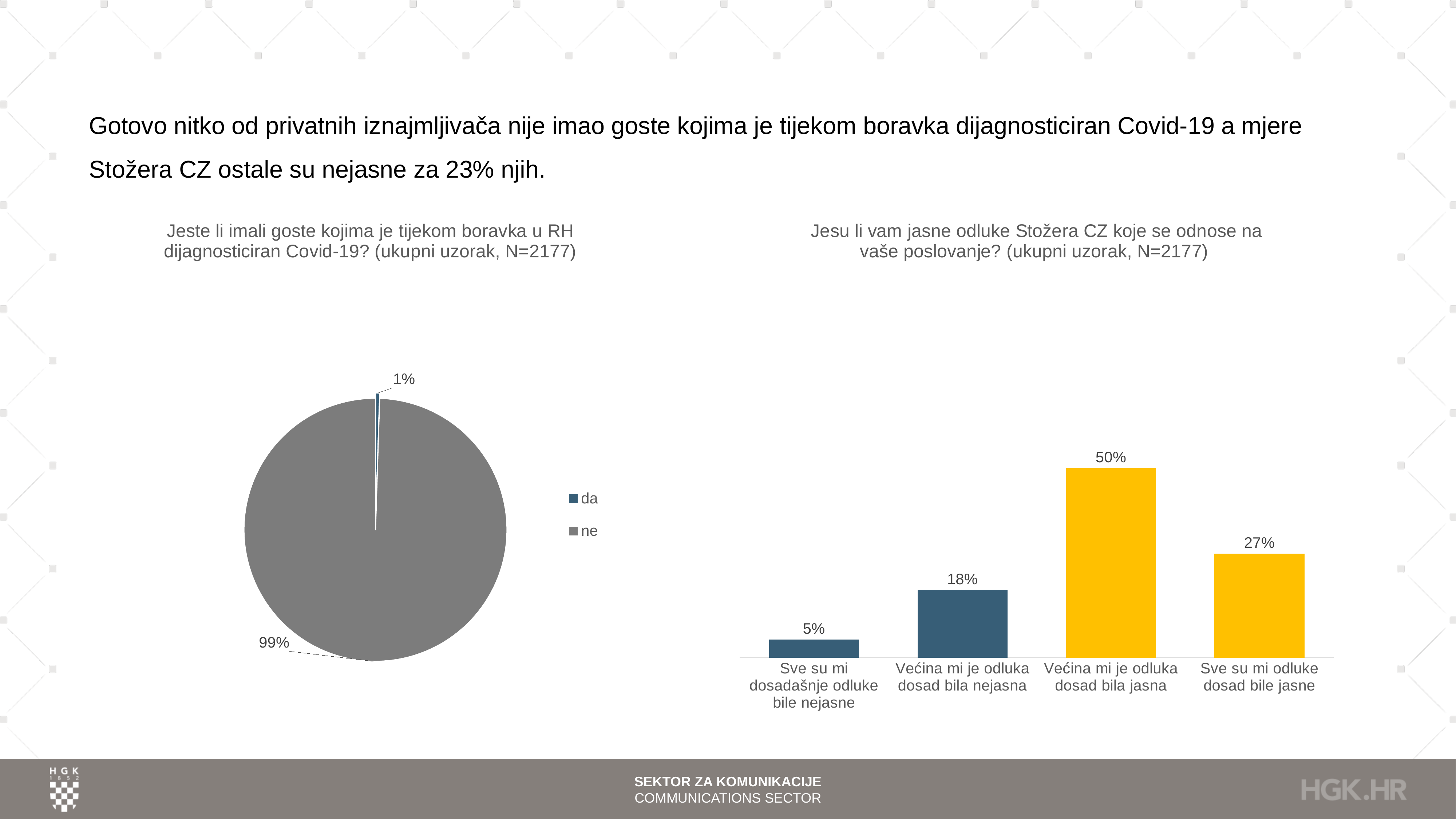
In the right chart (Jesu li vam jasne odluke Stožera CZ...), what is the value for 'Sve su mi dosadašnje odluke bile nejasne'? 5% How many entries does the legend of the left chart list? 2 In the right chart (Jesu li vam jasne odluke Stožera CZ...), which category has the highest value? Većina mi je odluka dosad bila jasna In the right chart (Jesu li vam jasne odluke Stožera CZ...), what is the difference between 'Većina mi je odluka dosad bila jasna' and 'Sve su mi odluke dosad bile jasne'? 23% In the left chart (Jeste li imali goste kojima je tijekom boravka u RH dijagnosticiran Covid-19?), what share of the pie is 'ne'? 99% What kind of chart is the right chart (Jesu li vam jasne odluke Stožera CZ koje se odnose na vaše poslovanje?)? bar chart In the left chart (Jeste li imali goste kojima je tijekom boravka u RH dijagnosticiran Covid-19?), what share of the pie is 'da'? 1% In the right chart (Jesu li vam jasne odluke Stožera CZ...), what is the value for 'Većina mi je odluka dosad bila jasna'? 50% What kind of chart is the left chart on the slide? pie chart How many categories are shown in the right chart (Jesu li vam jasne odluke Stožera CZ...)? 4 In the right chart (Jesu li vam jasne odluke Stožera CZ...), which category has the lowest value? Sve su mi dosadašnje odluke bile nejasne In the right chart (Jesu li vam jasne odluke Stožera CZ...), which is larger: 'Većina mi je odluka dosad bila nejasna' or 'Sve su mi odluke dosad bile jasne'? Sve su mi odluke dosad bile jasne